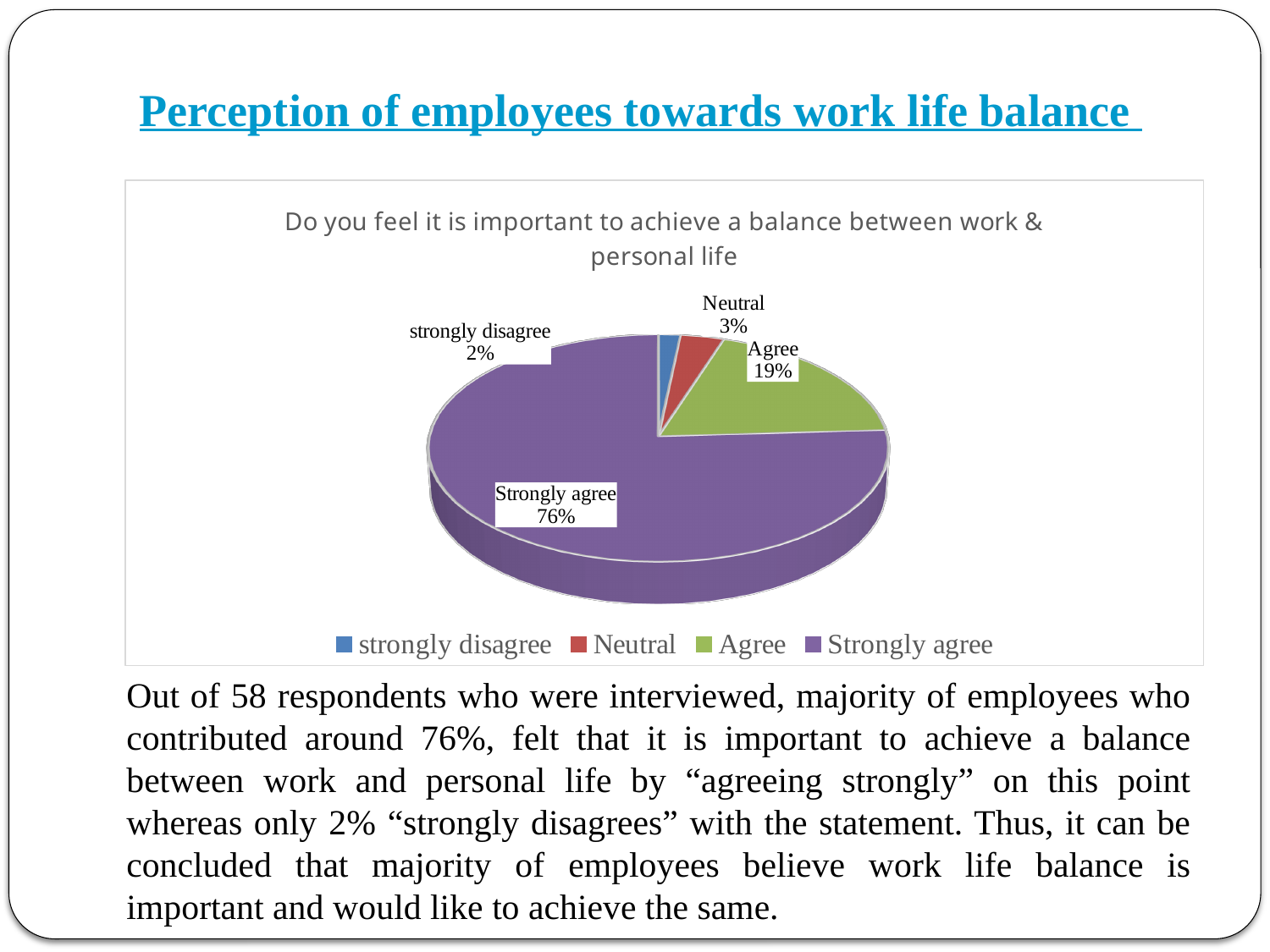
How many categories does the pie chart show? 4 What percentage of respondents chose 'strongly disagree'? 2% What is the title of the chart? Do you feel it is important to achieve a balance between work & personal life What percentage of respondents chose 'Strongly agree'? 76% What type of chart is shown on the slide? Pie chart Which category has the largest share of the pie? Strongly agree What colour represents 'Agree' in the pie chart? Green Which category has the smallest share of the pie? strongly disagree What percentage of respondents chose 'Neutral'? 3% What percentage of respondents chose 'Agree'? 19% What is the difference in percentage points between 'Strongly agree' and 'Agree'? 57 Which is larger, the share for 'Neutral' or the share for 'strongly disagree'? Neutral